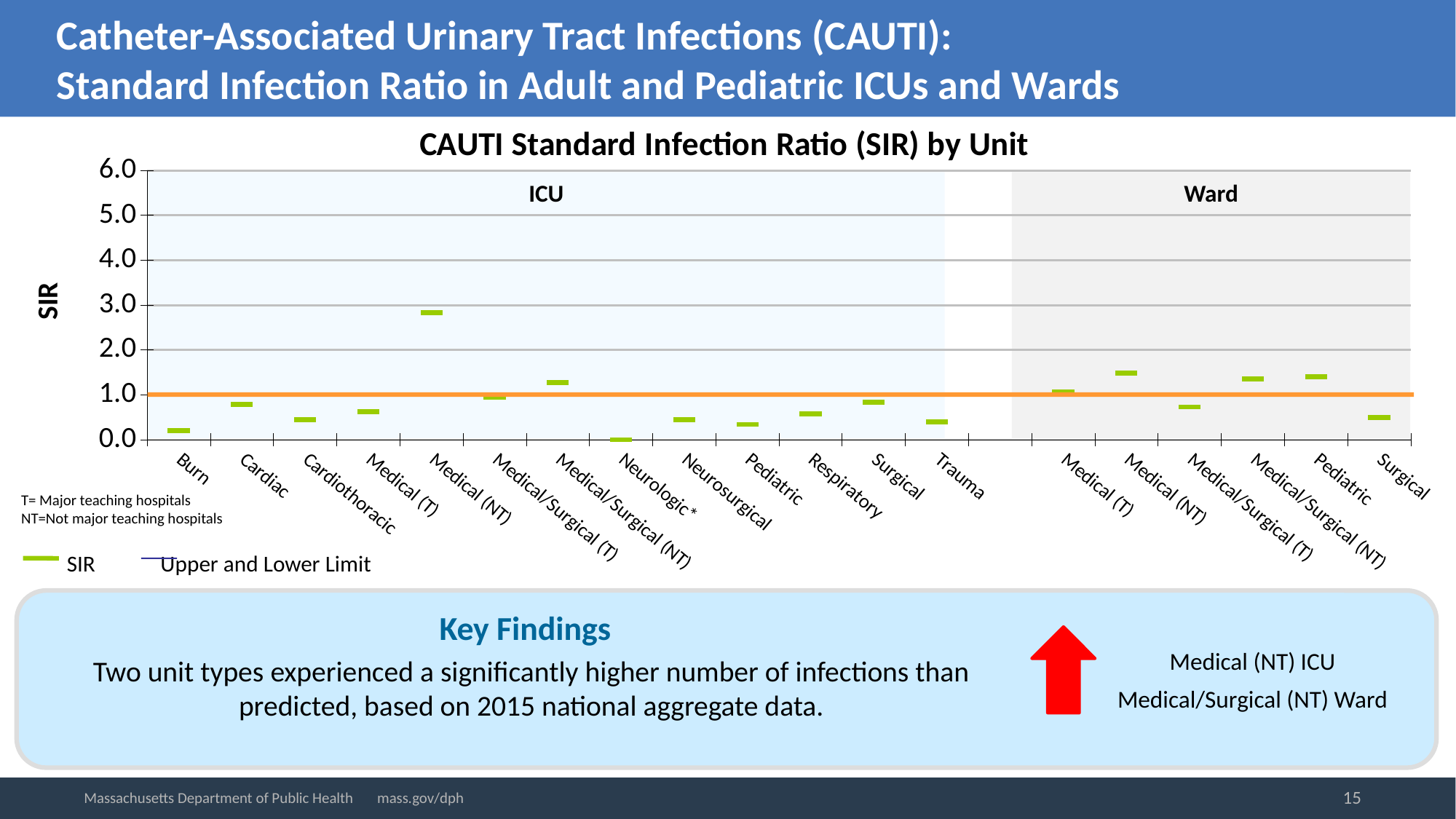
Which unit has the lowest SIR on the chart? Neurologic * ICU Is the SIR for Medical (NT) in the ICU section greater or less than 2.0? greater What is the title of the chart? CAUTI Standard Infection Ratio (SIR) by Unit What is the label of the y axis? SIR Which has the larger SIR: Medical (NT) ICU or Medical/Surgical (T) ICU? Medical (NT) ICU How many unit categories are plotted in the ICU section of the chart? 13 How many unit categories are plotted in the Ward section of the chart? 6 How many entries does the chart legend list? 2 Which unit has the highest SIR on the chart? Medical (NT) ICU Is the SIR for Burn ICU greater or less than 1.0? less How many unit categories are plotted on the x axis in total? 19 Is the SIR for Medical/Surgical (NT) in the Ward section greater or less than 1.0? greater